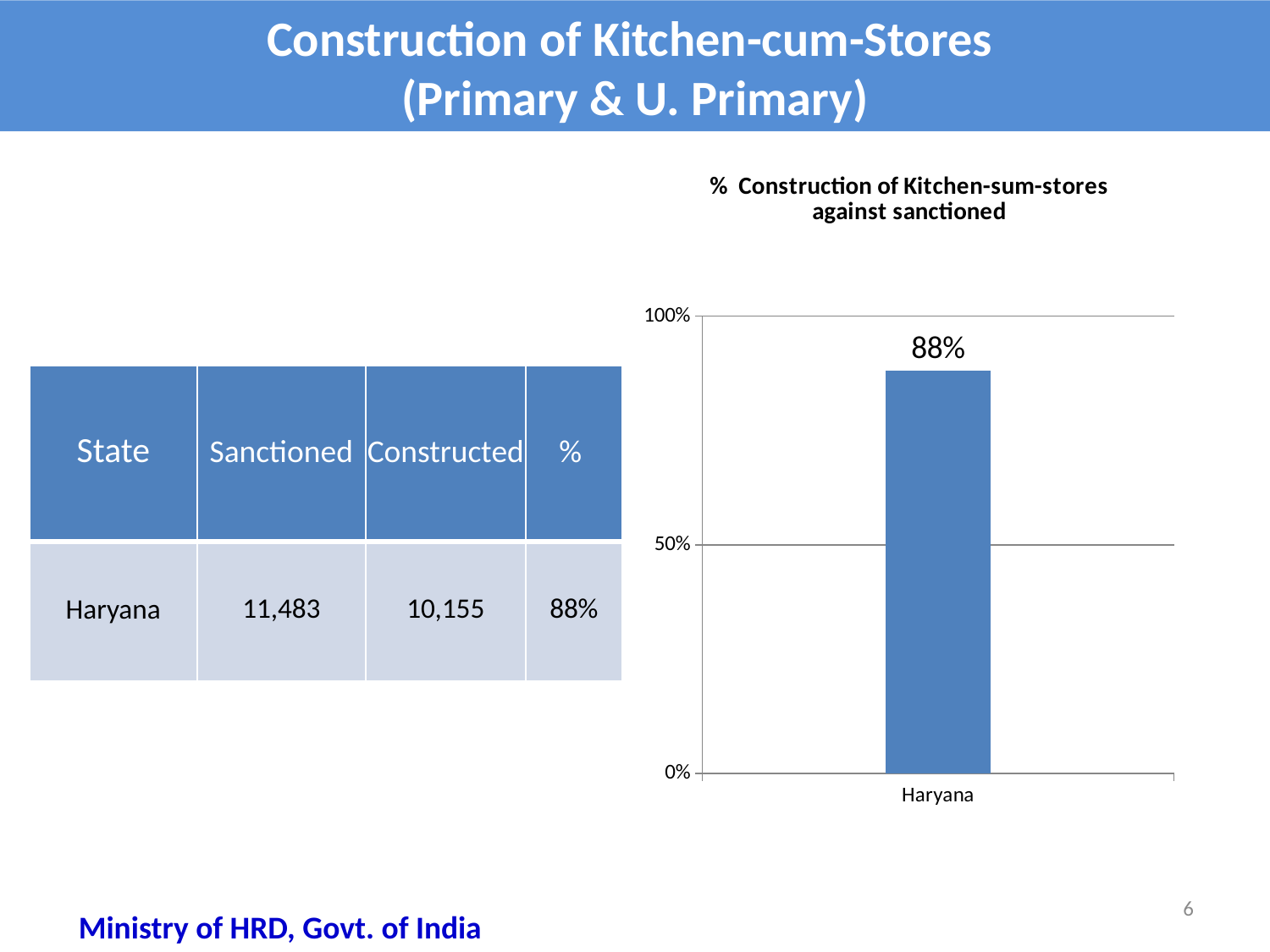
Is the value for Haryana greater or less than 100%? less Which state is shown on the x axis of the chart? Haryana Is the value for Haryana greater or less than 50%? greater What kind of chart is shown on the slide? bar chart What is the title of the chart? % Construction of Kitchen-sum-stores against sanctioned How many categories are plotted on the x axis of the chart? 1 What is the value for Haryana in the chart? 88% What is the highest tick value shown on the y axis of the chart? 100%